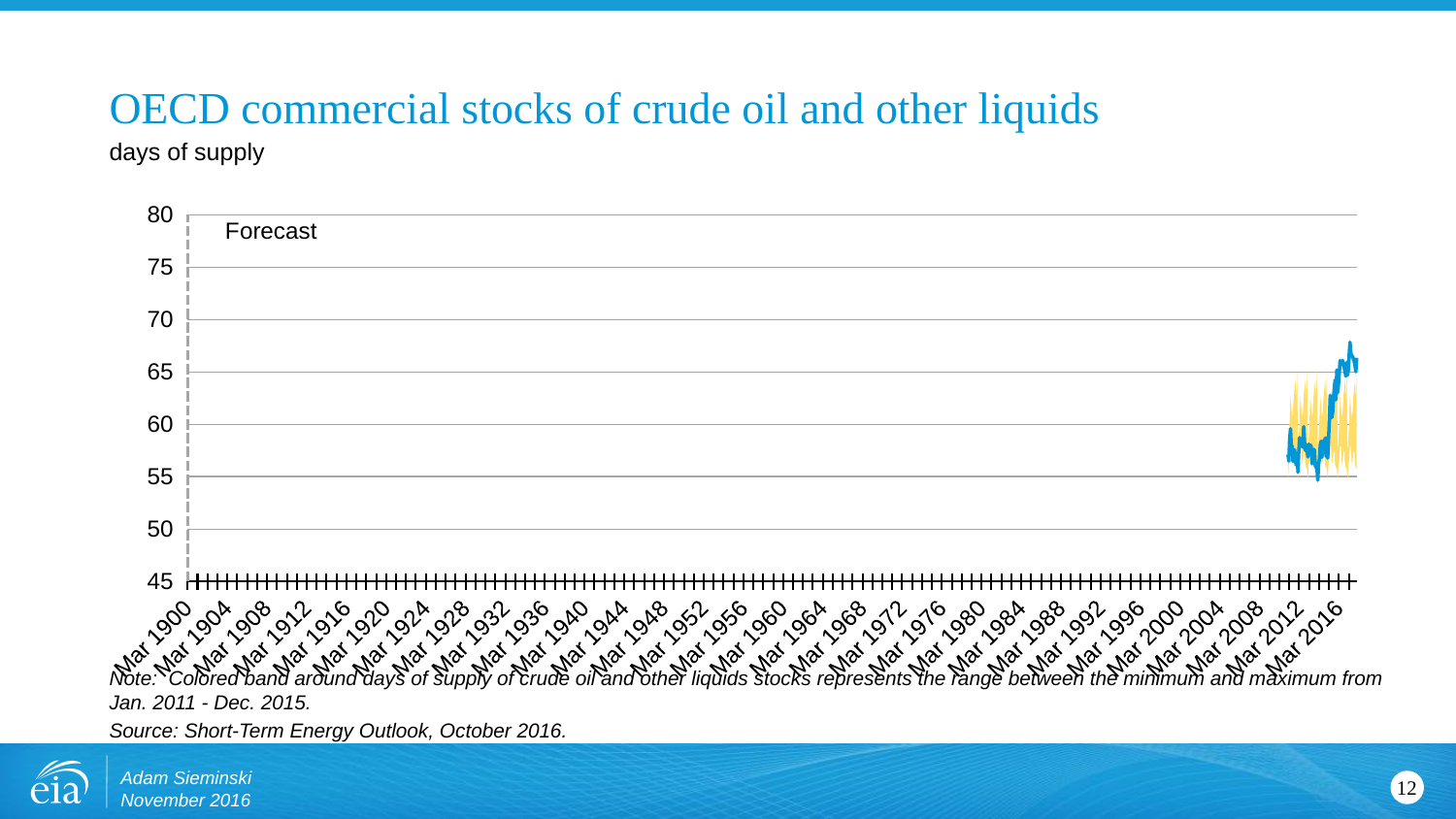
Is the value of the plotted line at its right-hand end greater or less than 60? greater In what unit are the values on the chart expressed? days of supply Toward the right end of the series (the most recent years), do the plotted values rise or fall? rise What kind of chart is shown on the slide? line chart Is the highest point of the plotted blue line greater or less than 70? less What is the title of the chart? OECD commercial stocks of crude oil and other liquids Is the lowest point of the plotted blue line greater or less than 50? greater